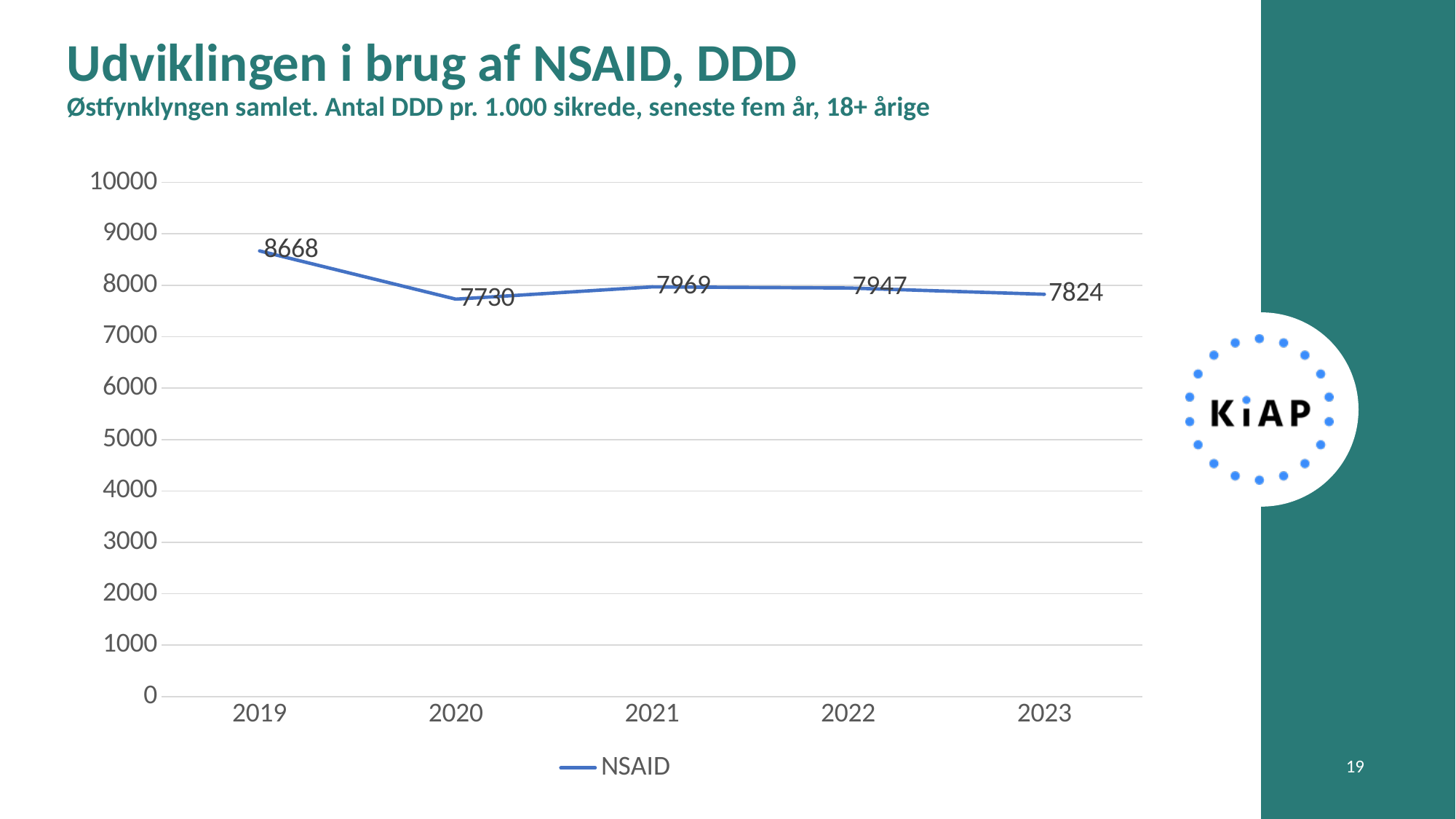
What is the NSAID value for 2019? 8668 What is the difference between the NSAID values for 2021 and 2023? 145 What is the difference between the NSAID values for 2019 and 2020? 938 How many years are shown on the x axis? 5 What kind of chart is shown on the slide? line chart Which year has the lowest NSAID value? 2020 What is the name of the series shown in the legend? NSAID Which is larger, the NSAID value for 2019 or for 2023? 2019 Is the NSAID value for 2022 greater or less than 9000? less What is the NSAID value for 2023? 7824 Which year has the highest NSAID value? 2019 What is the NSAID value for 2020? 7730